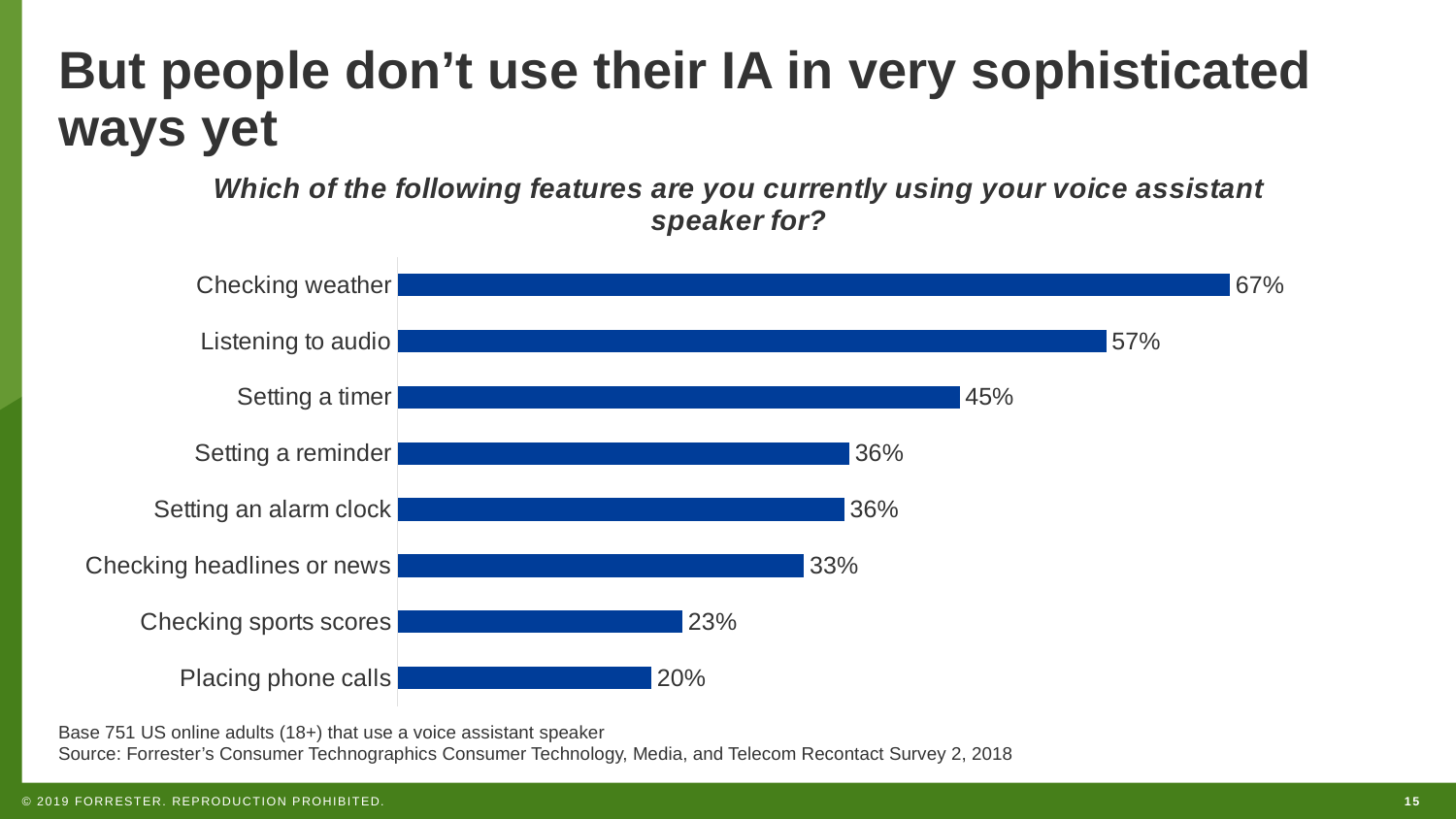
Which is larger, the value for Setting a timer or the value for Checking headlines or news? Setting a timer What is the value shown for Setting a timer? 45% What percentage is shown for Placing phone calls? 20% What is the title of the chart? Which of the following features are you currently using your voice assistant speaker for? What is the difference between Checking headlines or news and Checking sports scores? 10% Which two features share the same value of 36%? Setting a reminder and Setting an alarm clock What percentage of respondents use their voice assistant speaker for checking weather? 67% What is the difference between the percentages for Checking weather and Listening to audio? 10% How many features are listed in the chart? 8 Which feature has the highest percentage of users? Checking weather Which feature has the lowest percentage of users? Placing phone calls What type of chart is shown on the slide? Bar chart